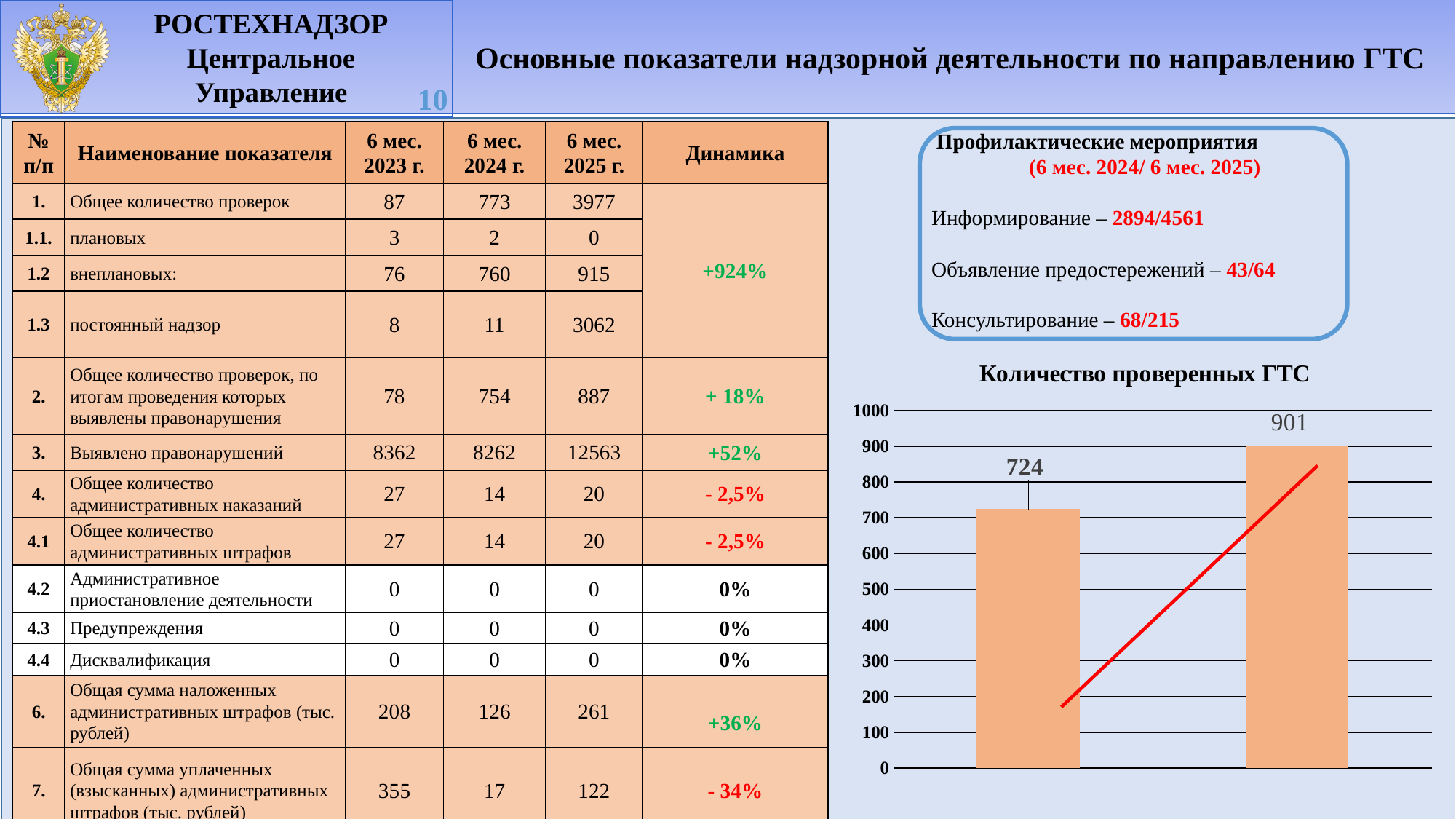
In the chart "Количество проверенных ГТС", what is the value of the left bar? 724 What kind of chart is shown under the title "Количество проверенных ГТС"? bar chart In the chart "Количество проверенных ГТС", which bar is taller, the left or the right? right In the chart "Количество проверенных ГТС", what is the value of the right bar? 901 In the chart "Количество проверенных ГТС", which bar has the lowest value? the left bar (724) In the chart "Количество проверенных ГТС", what is the difference between the right bar and the left bar? 177 In the chart "Количество проверенных ГТС", is the value of the right bar greater or less than 1000? less In the chart "Количество проверенных ГТС", do the values rise or fall from left to right? rise What is the title of the chart on the slide? Количество проверенных ГТС In the chart "Количество проверенных ГТС", is the value of the left bar greater or less than 700? greater How many bars are plotted in the chart "Количество проверенных ГТС"? 2 What is the highest tick value shown on the vertical axis of the chart "Количество проверенных ГТС"? 1000